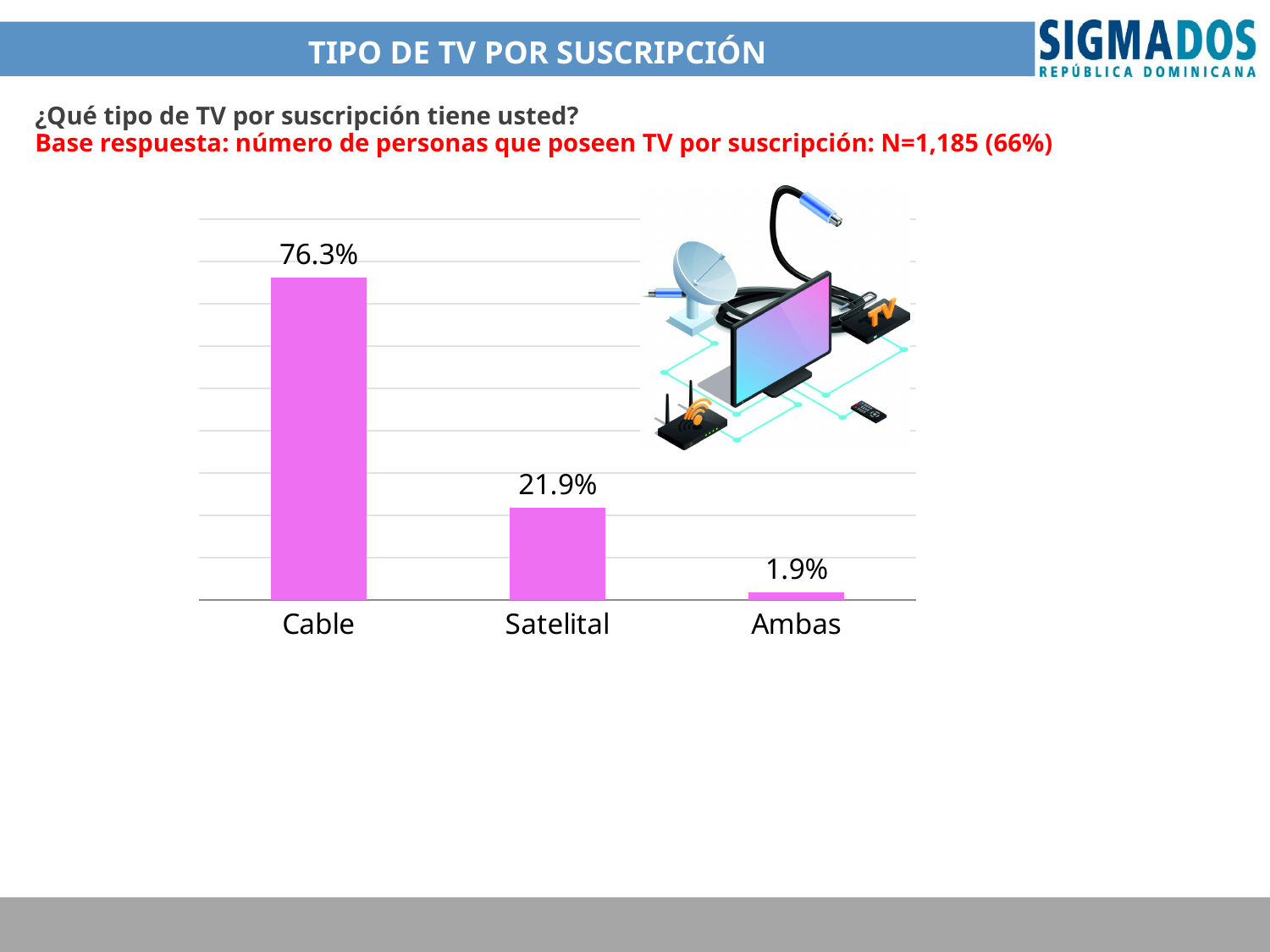
What is the value for Cable? 76.3% What is the value for Ambas? 1.9% Which category has the highest value? Cable Which category has the lowest value? Ambas What kind of chart is shown on the slide? Bar chart What is the difference between the values for Satelital and Ambas? 20.0% Do the values rise or fall from Cable to Ambas along the x axis? Fall Which is larger, the value for Satelital or the value for Ambas? Satelital What is the title of the slide containing the chart? TIPO DE TV POR SUSCRIPCIÓN What is the value for Satelital? 21.9% What is the difference between the values for Cable and Satelital? 54.4% How many categories are shown in the chart? 3